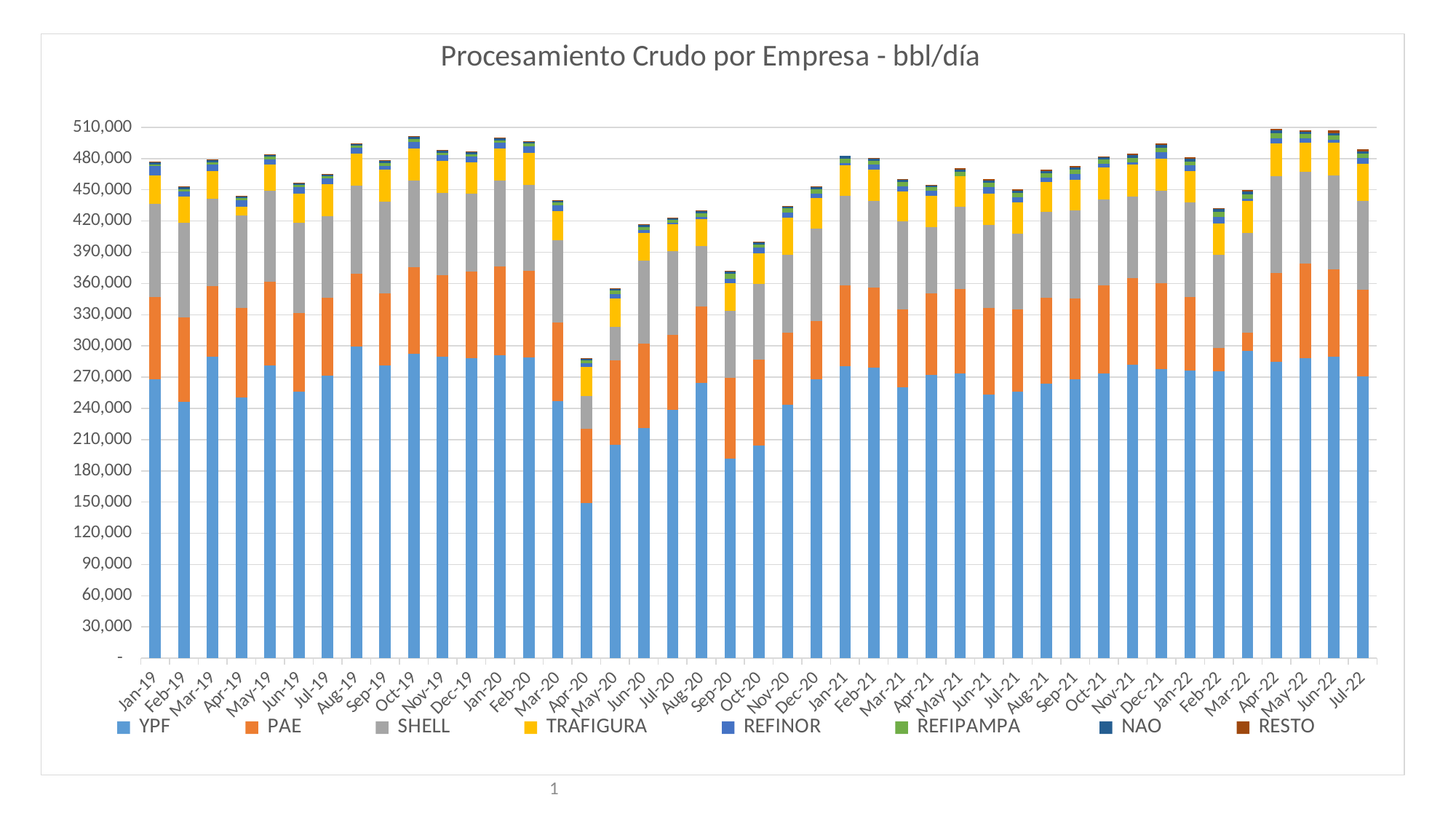
Is the YPF value for Apr-20 greater or less than 180,000? less What is the title of the chart? Procesamiento Crudo por Empresa - bbl/día Is the total for Jan-19 greater or less than 450,000? greater How many series does the legend list? 8 Is the YPF value for Sep-20 greater or less than 180,000? greater Which series forms the bottom segment of each stacked bar? YPF Which month has the lowest total crude processing? Apr-20 Which has the larger total, Jan-20 or Apr-20? Jan-20 Do the total values rise or fall from Apr-20 to Jan-21? rise What kind of chart is shown on the slide? Stacked bar chart How many months (bars) are plotted along the x axis? 43